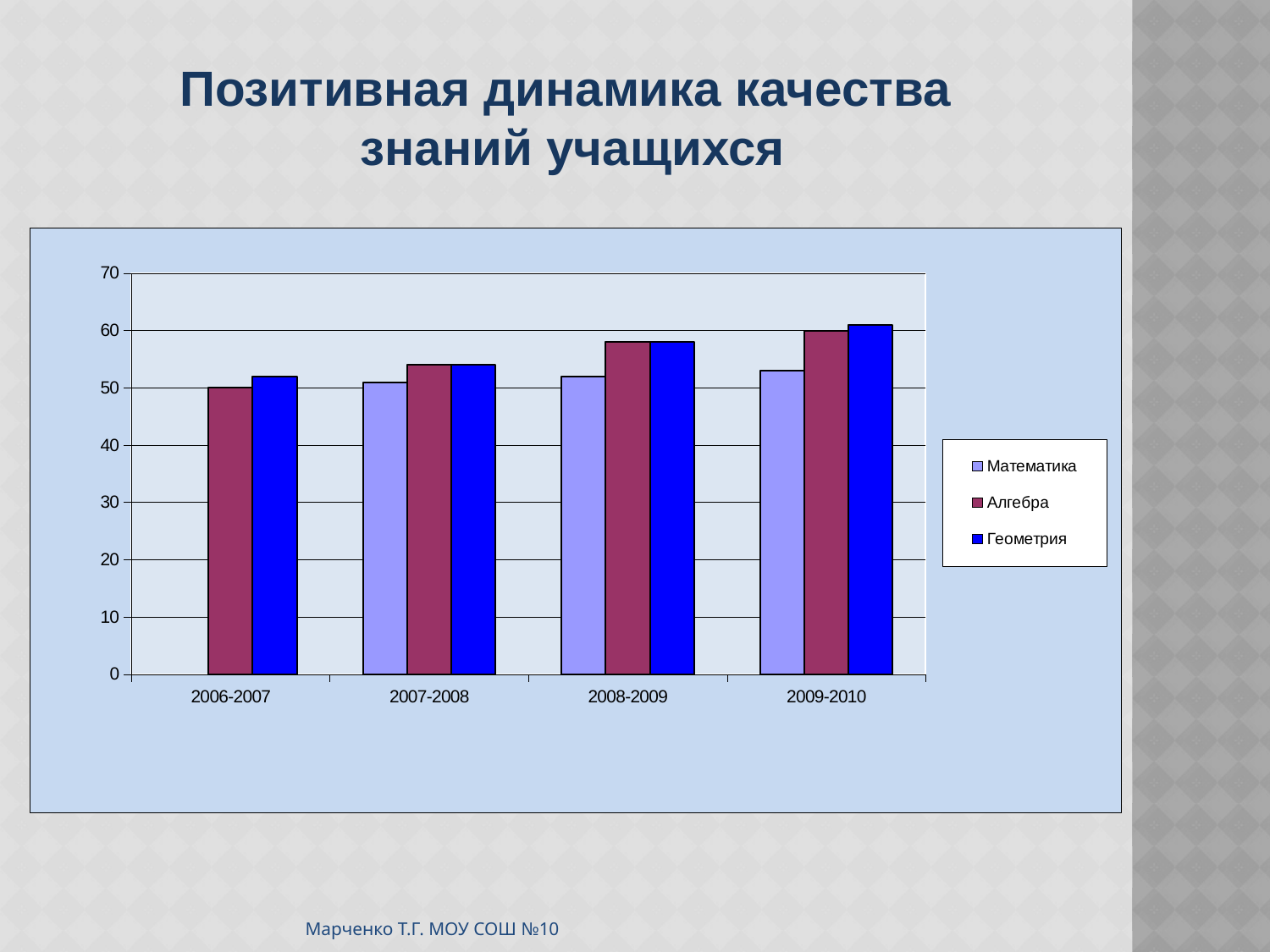
Is the value for Математика in 2008-2009 greater or less than 50? greater In 2009-2010, which is larger: the value for Математика or the value for Геометрия? Геометрия Do the Математика values rise or fall from 2007-2008 to 2009-2010? rise How many series does the legend list? 3 Is the value for Геометрия in 2006-2007 greater or less than 50? greater What kind of chart is shown on the slide? bar chart How many school-year categories are shown on the x axis? 4 Is the value for Геометрия in 2009-2010 greater or less than 60? greater Which school year has the highest Геометрия value? 2009-2010 What is the title of the slide above the chart? Позитивная динамика качества знаний учащихся What is the value for Алгебра in 2006-2007? 50